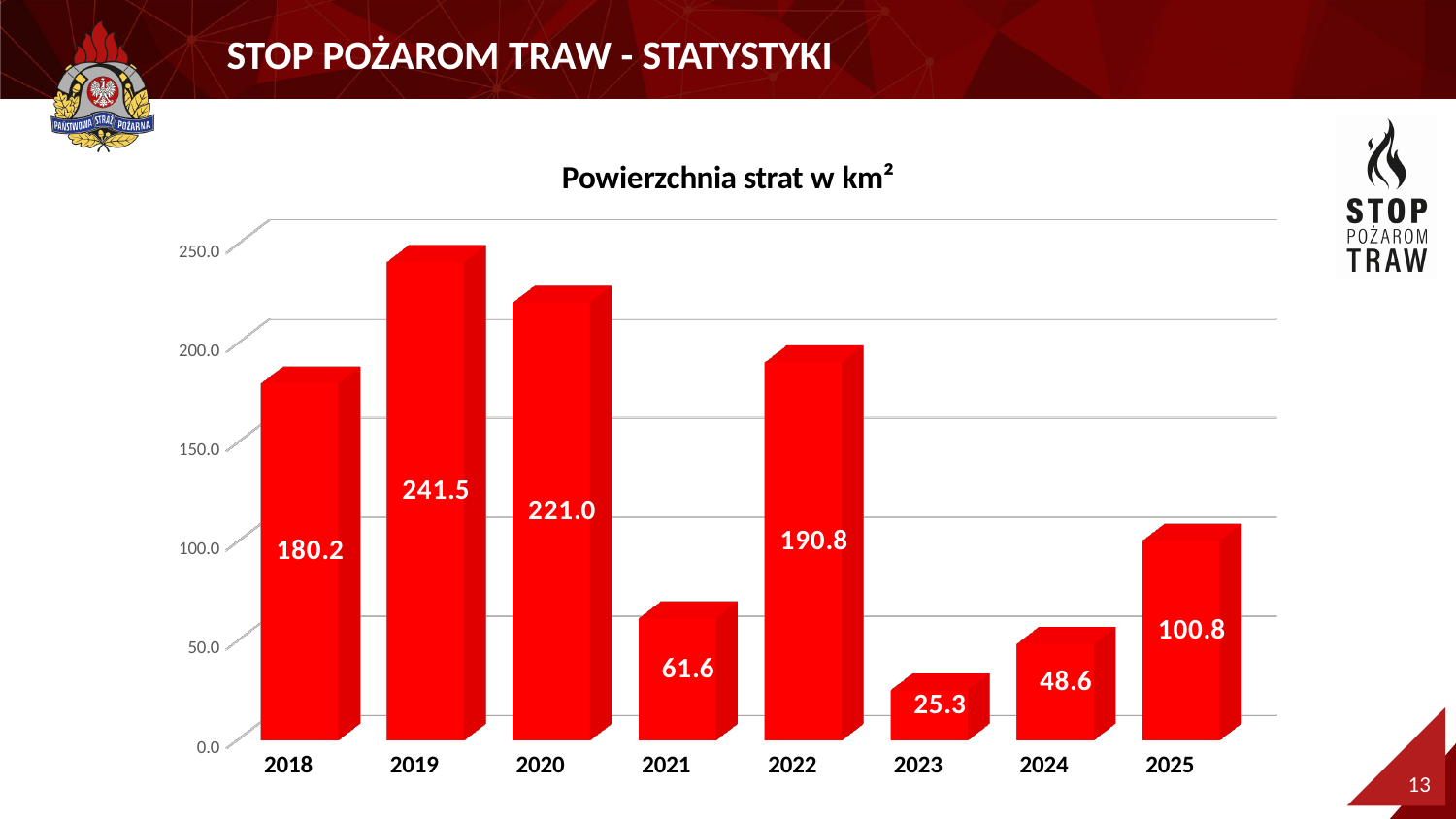
What is the difference between the values for 2019 and 2020? 20.5 What is the value for 2025? 100.8 Which year has the highest value? 2019 How many years are shown on the x axis? 8 What is the value for 2019? 241.5 Which year has the lowest value? 2023 What is the title of the chart? Powierzchnia strat w km² Is the value for 2021 greater or less than 100.0? less What kind of chart is shown? bar chart Which is larger, the value for 2018 or the value for 2022? 2022 What is the value for 2023? 25.3 What is the difference between the values for 2025 and 2024? 52.2